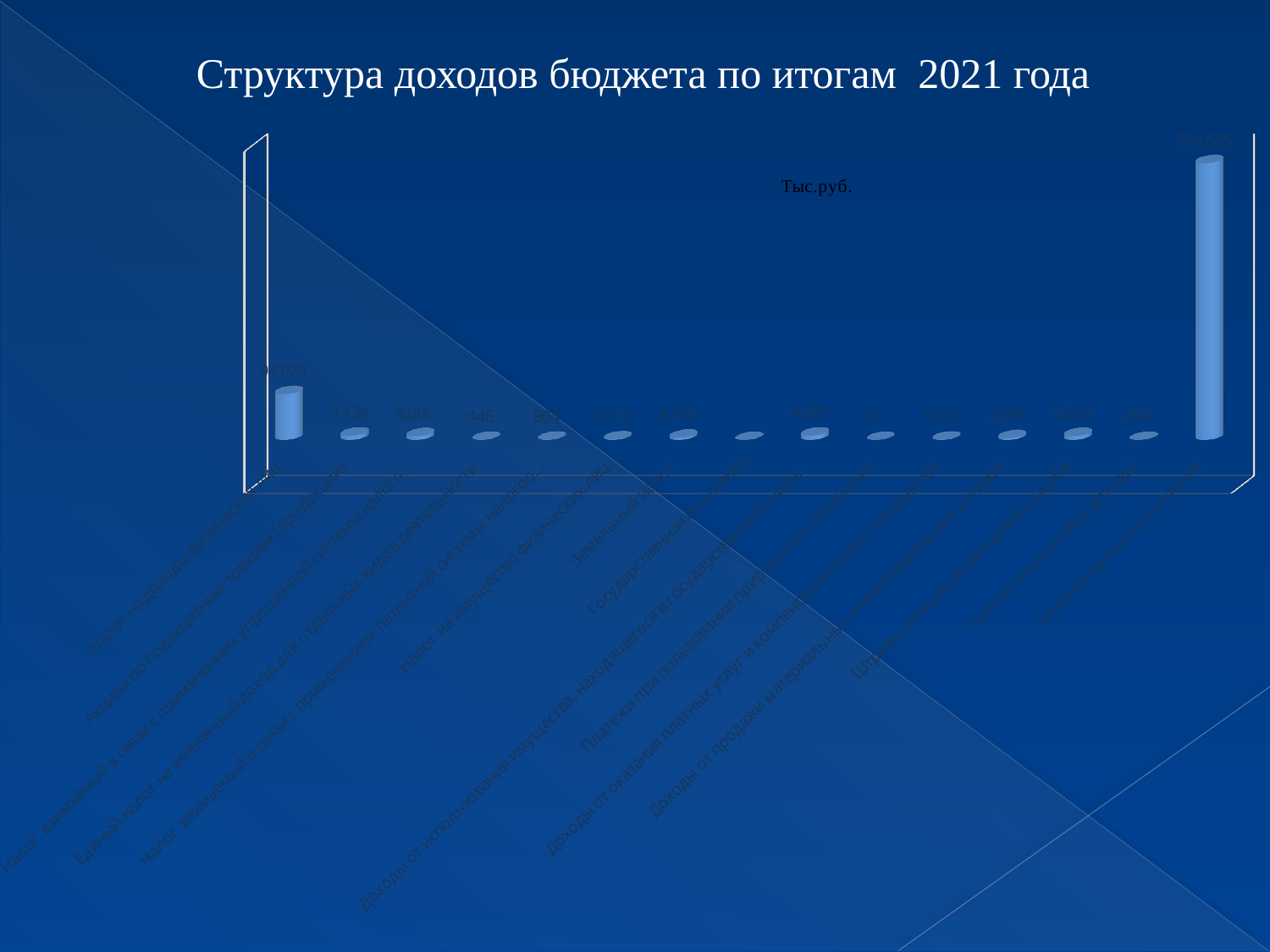
What is the value for Налог, взимаемый в связи с применением упрощенной системы налогообложения? 8,096 Which is larger: the value for Акцизы по подакцизным товарам (продукции) or the value for Единый налог на вмененный доход для отдельных видов деятельности? Акцизы по подакцизным товарам (продукции) How many categories (bars) are plotted in the chart? 15 What is the title of the chart? Структура доходов бюджета по итогам 2021 года What unit is indicated on the chart? Тыс.руб. Which is larger: the value for Налог на доходы физических лиц or the value for Безвозмездные поступления? Безвозмездные поступления Which category has the highest value in the chart? Безвозмездные поступления What kind of chart is shown on the slide? bar chart Which is larger: the value for Налог на доходы физических лиц or the value for Акцизы по подакцизным товарам (продукции)? Налог на доходы физических лиц What is the value for Акцизы по подакцизным товарам (продукции)? 9,134